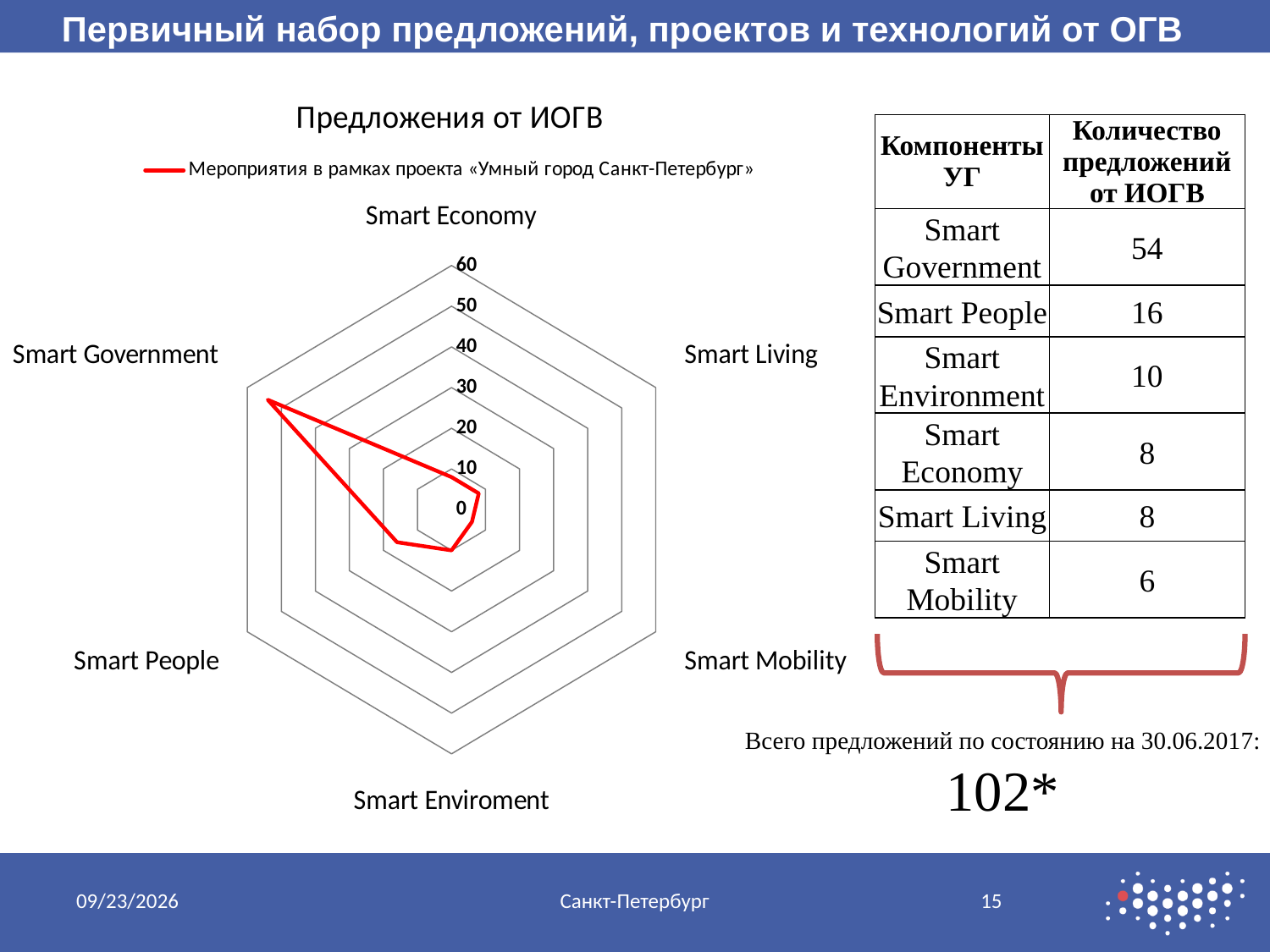
Which is larger, the value for Smart People or the value for Smart Environment? Smart People What is the number of proposals for Smart People? 16 What is the number of proposals for Smart Government? 54 Is the value for Smart Government on the radar chart greater or less than 50? greater Which category has the lowest number of proposals according to the table? Smart Mobility What is the title of the radar chart? Предложения от ИОГВ How many series does the chart legend list? 1 How many categories (axes) does the radar chart have? 6 What kind of chart is shown on the slide? Radar chart Which category has the highest value on the radar chart? Smart Government What is the difference between the values for Smart Government and Smart People? 38 What is the total number of proposals across all six components? 102